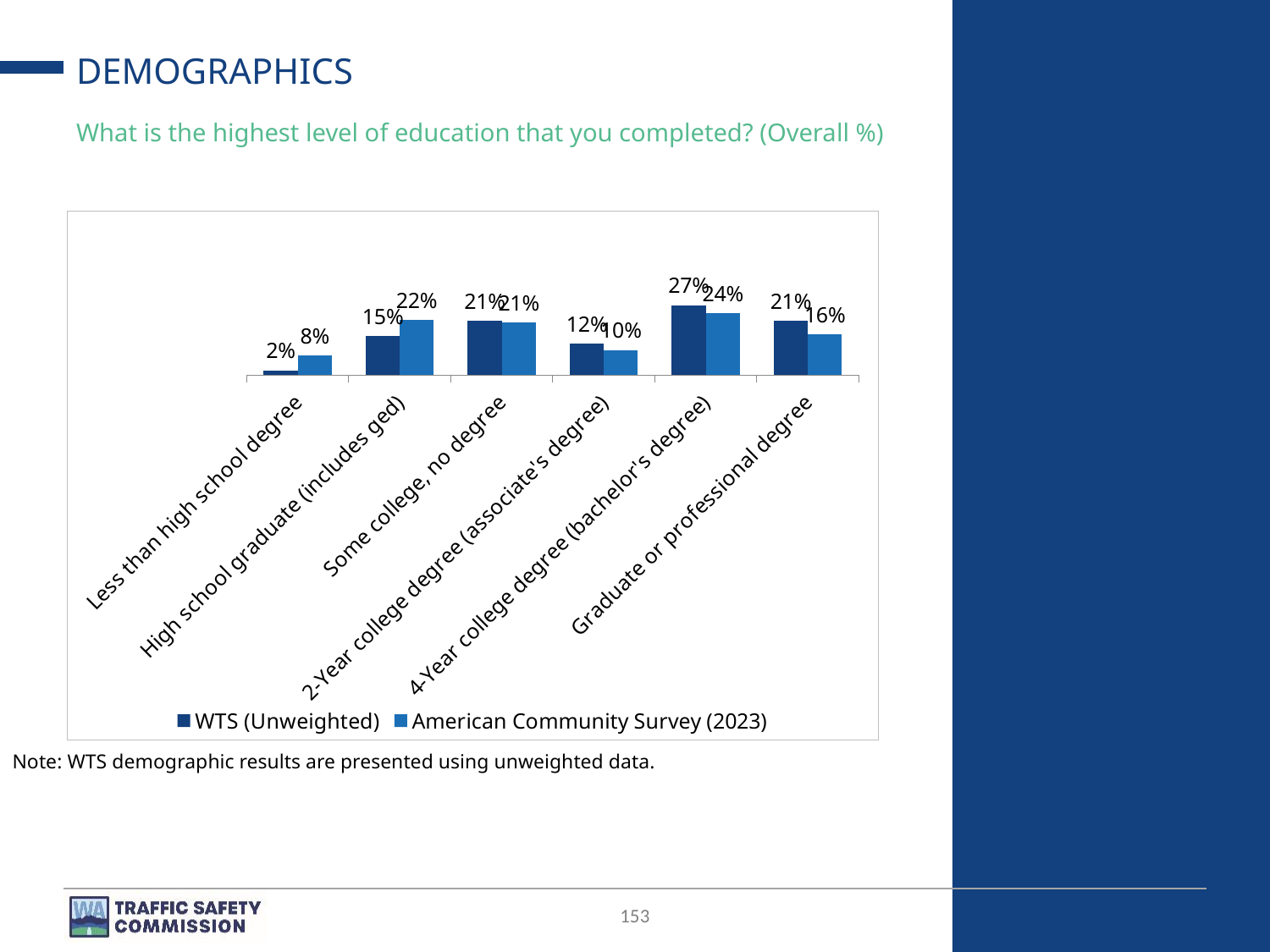
Which category has the lowest American Community Survey (2023) value? Less than high school degree Which category has the highest WTS (Unweighted) value? 4-Year college degree (bachelor's degree) What is the American Community Survey (2023) value for Graduate or professional degree? 16% How many education categories are shown on the x axis? 6 What is the difference between the WTS (Unweighted) and American Community Survey (2023) values for Graduate or professional degree? 5% What is the WTS (Unweighted) value for 4-Year college degree (bachelor's degree)? 27% What is the American Community Survey (2023) value for High school graduate (includes ged)? 22% What kind of chart is shown on the slide? Bar chart What is the WTS (Unweighted) value for 2-Year college degree (associate's degree)? 12% What is the WTS (Unweighted) value for Less than high school degree? 2% How many series does the legend list? 2 For High school graduate (includes ged), which series has the larger value, WTS (Unweighted) or American Community Survey (2023)? American Community Survey (2023)